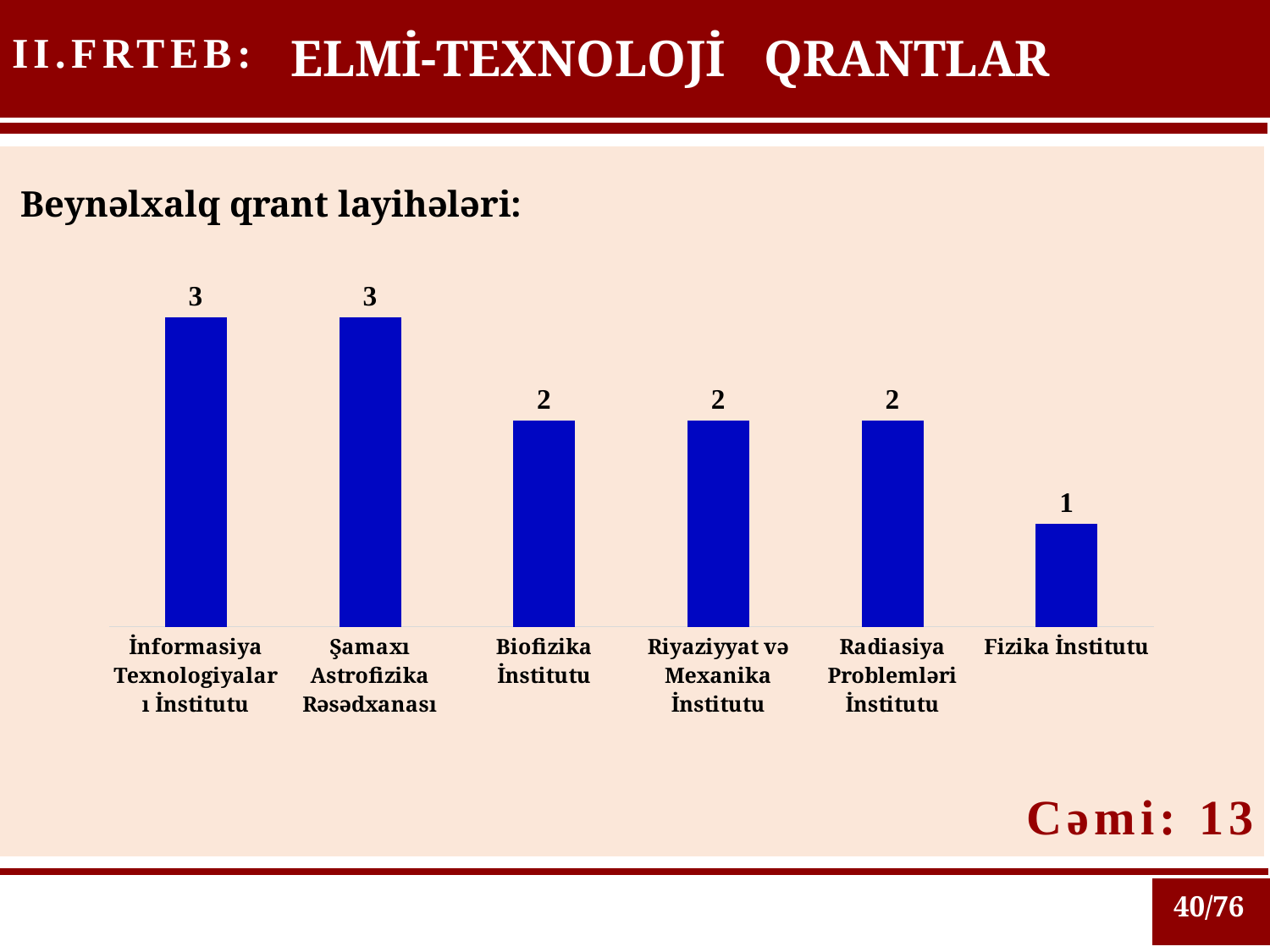
What is the value for Biofizika İnstitutu? 2 What colour are the bars in the chart? Blue What is the value for Şamaxı Astrofizika Rəsədxanası? 3 What is the difference between the values for İnformasiya Texnologiyaları İnstitutu and Fizika İnstitutu? 2 Which is larger, the value for Şamaxı Astrofizika Rəsədxanası or the value for Riyaziyyat və Mexanika İnstitutu? Şamaxı Astrofizika Rəsədxanası What is the value for Fizika İnstitutu? 1 Do the values rise or fall from left to right along the x axis? Fall How many categories are shown in the chart? 6 What total (Cəmi) is printed on the slide for the chart? 13 Which category has the lowest value? Fizika İnstitutu What is the value for Radiasiya Problemləri İnstitutu? 2 What kind of chart is shown on the slide? Bar chart